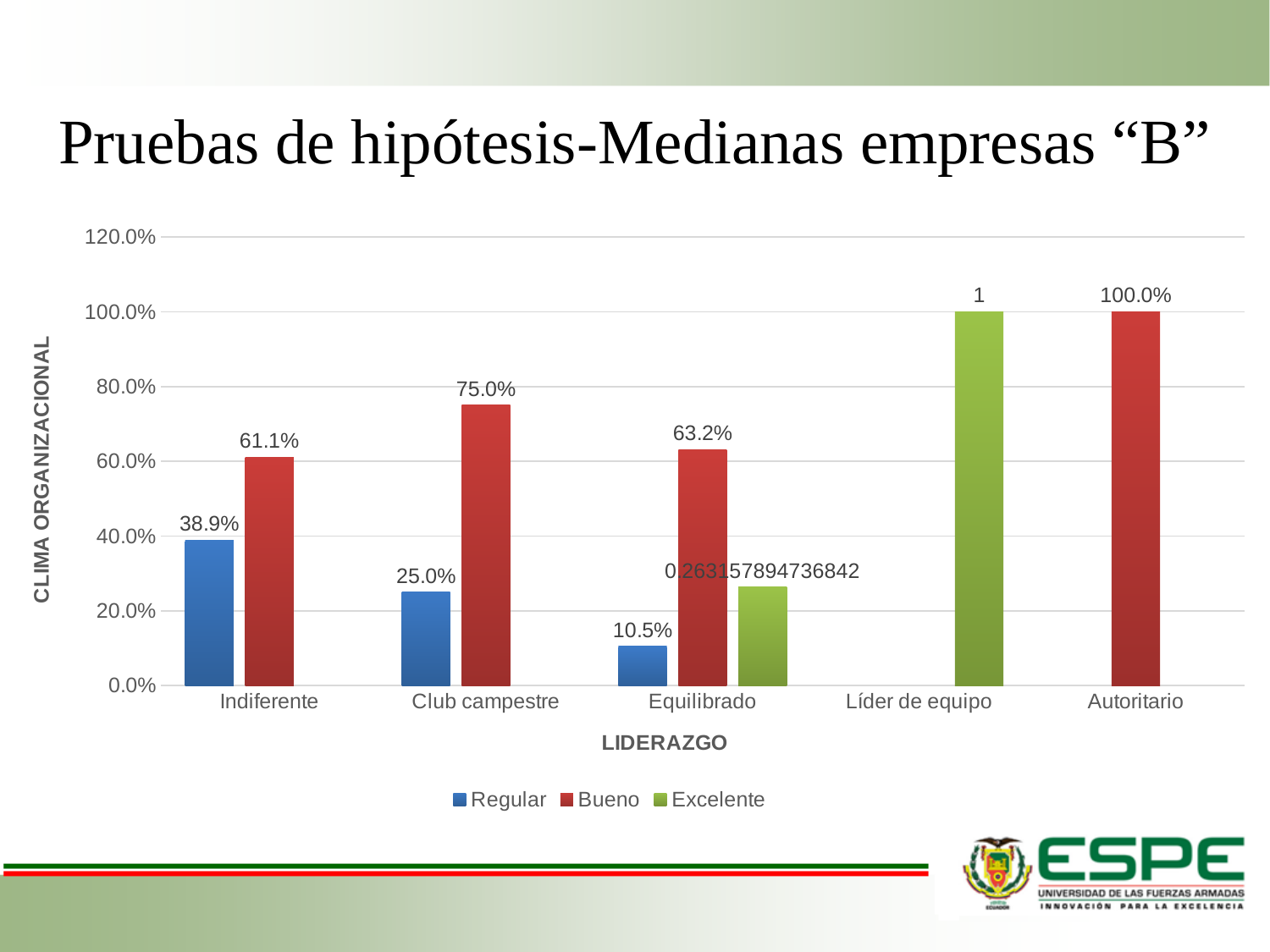
What is the value for Bueno in the Autoritario category? 100.0% What is the value for Bueno in the Indiferente category? 61.1% What is the value for Bueno in the Equilibrado category? 63.2% How many series does the legend list? 3 Which category has the lowest value for the Regular series? Equilibrado What is the value for Regular in the Club campestre category? 25.0% How many categories are shown on the x axis? 5 What is the difference between the Bueno and Regular values in the Club campestre category? 50.0% Which is larger in the Indiferente category, Regular or Bueno? Bueno What kind of chart is shown on the slide? Bar chart Which category has the highest value for the Regular series? Indiferente What is the value for Regular in the Equilibrado category? 10.5%